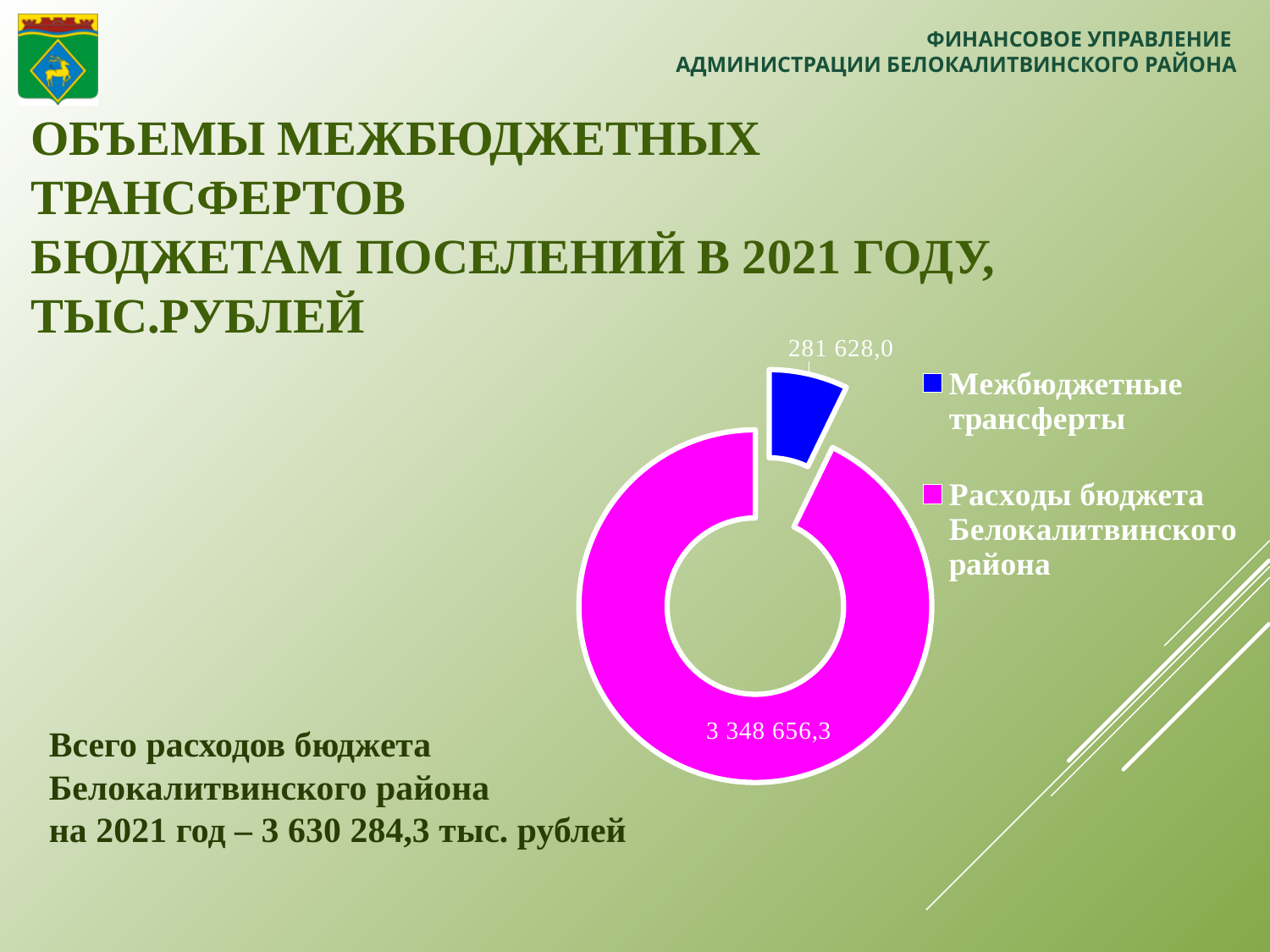
What kind of chart is shown on the slide? doughnut chart How many entries does the legend list? 2 Which category has the smallest slice in the chart? Межбюджетные трансферты What is the difference between Расходы бюджета Белокалитвинского района and Межбюджетные трансферты? 3 067 028,3 What is the value for Расходы бюджета Белокалитвинского района in the chart? 3 348 656,3 What colour is the slice for Межбюджетные трансферты? blue What colour is the slice for Расходы бюджета Белокалитвинского района? magenta Which category has the largest slice in the chart? Расходы бюджета Белокалитвинского района Which is larger: Межбюджетные трансферты or Расходы бюджета Белокалитвинского района? Расходы бюджета Белокалитвинского района How many slices does the chart have? 2 What is the value for Межбюджетные трансферты in the chart? 281 628,0 What is the total of the two values shown in the chart? 3 630 284,3